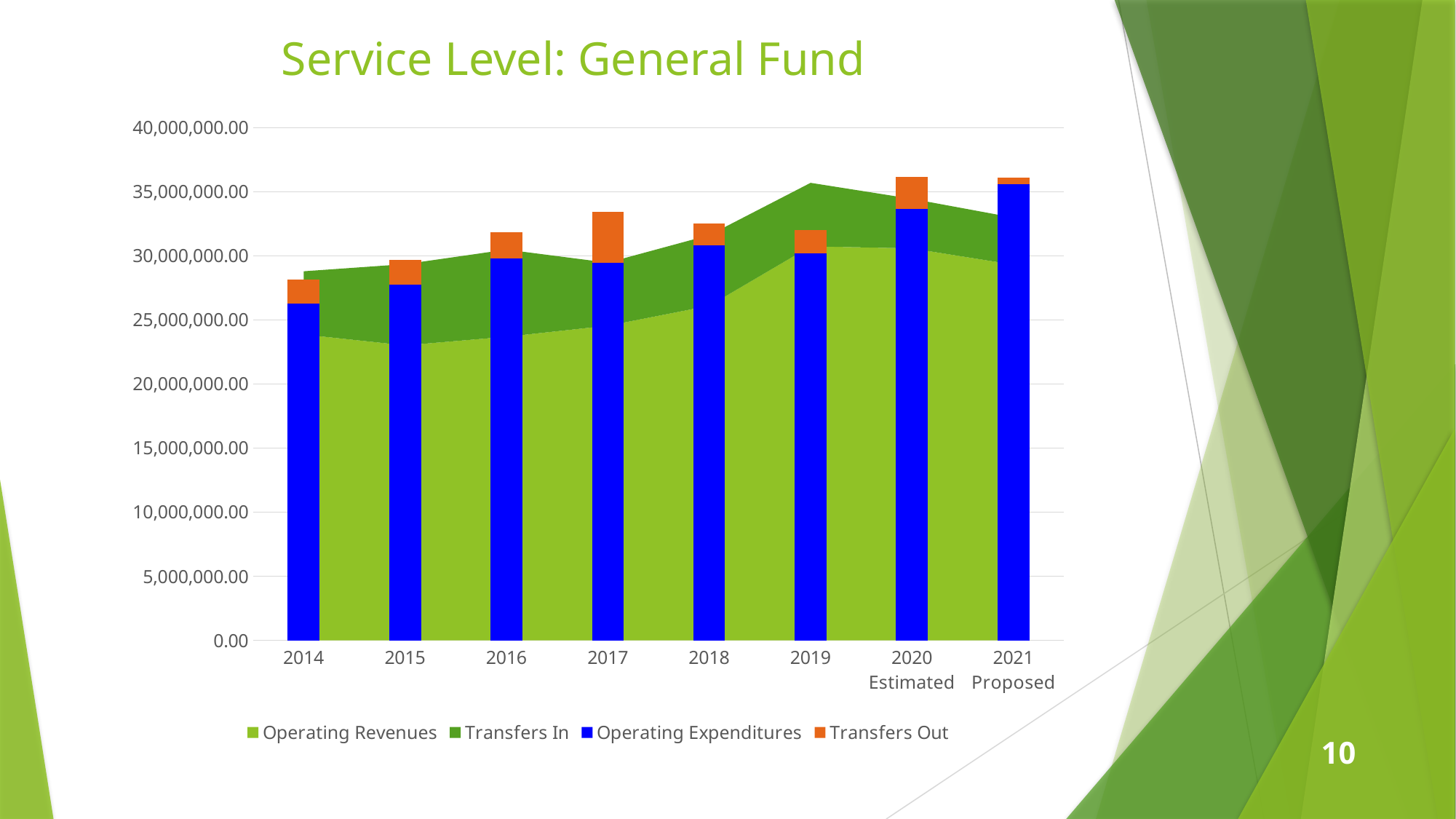
Which year has the lowest Operating Expenditures? 2014 Do Operating Expenditures generally rise or fall from 2014 to 2021 Proposed? rise How many years (categories) are shown on the x axis? 8 Which year has the highest Operating Expenditures? 2021 Proposed Which is larger, Operating Expenditures in 2019 or in 2020 Estimated? 2020 Estimated How many series does the legend list? 4 Is the Operating Expenditures value for 2014 greater or less than 30,000,000.00? less What kind of chart is used to show Operating Expenditures? bar chart Which year has the largest Transfers Out segment? 2017 Is the Operating Expenditures value for 2021 Proposed greater or less than 35,000,000.00? greater Is the Operating Expenditures value for 2020 Estimated greater or less than 35,000,000.00? less What colour represents Transfers Out in the legend? orange